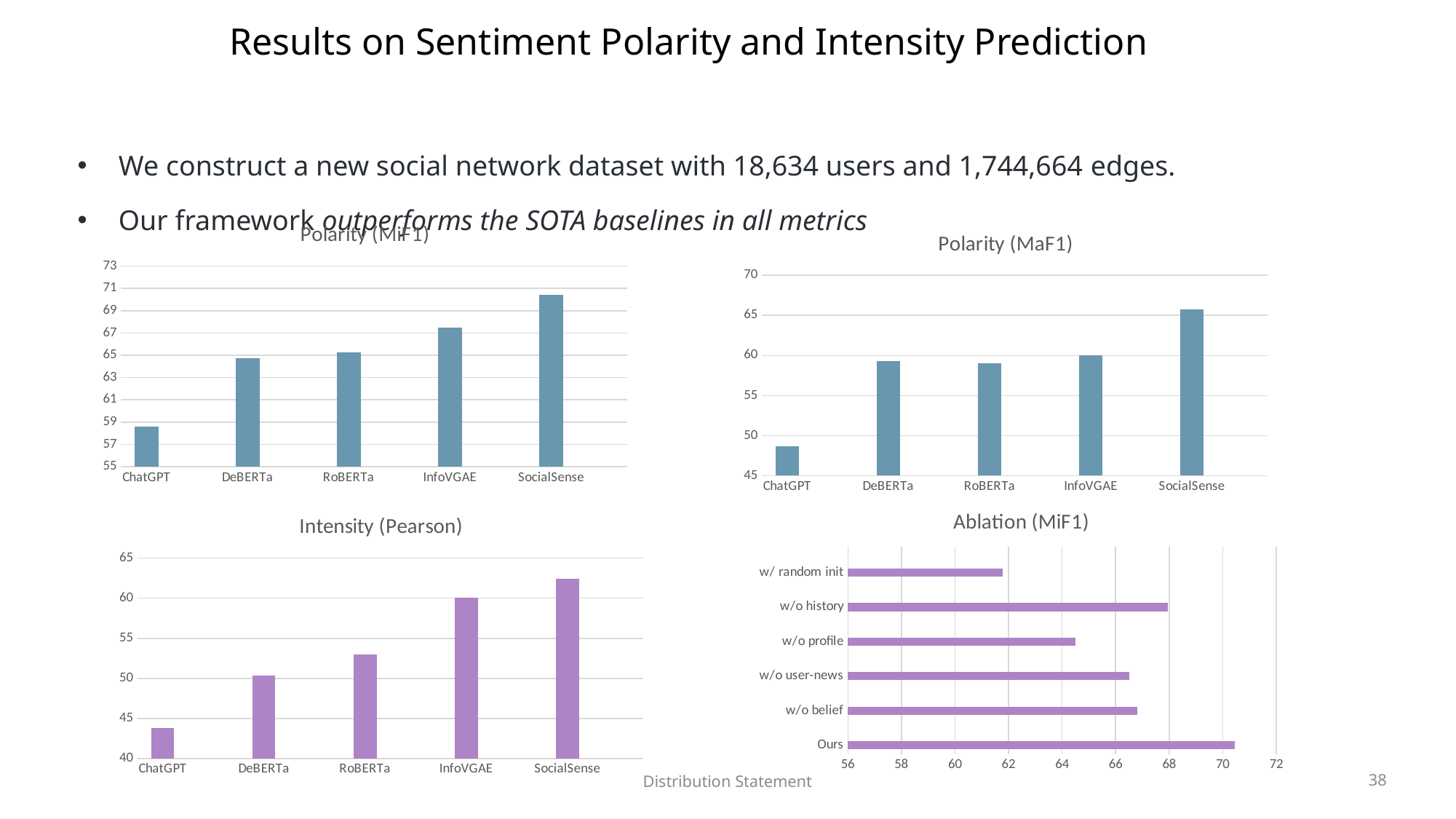
In the Polarity (MiF1) chart, is the value for ChatGPT greater or less than 59? less In the Ablation (MiF1) chart, which configuration has the lowest value? w/ random init In the Polarity (MaF1) chart, which is larger, the value for InfoVGAE or the value for SocialSense? SocialSense In the Intensity (Pearson) chart, do the values rise or fall from ChatGPT to SocialSense along the x axis? rise In the Polarity (MaF1) chart, is the value for SocialSense greater or less than 65? greater How many configurations are shown in the Ablation (MiF1) chart? 6 In the Polarity (MiF1) chart, which model has the lowest value? ChatGPT In the Polarity (MaF1) chart, which model has the lowest value? ChatGPT In the Intensity (Pearson) chart, is the value for ChatGPT greater or less than 45? less In the Intensity (Pearson) chart, which model has the highest value? SocialSense In the Ablation (MiF1) chart, which configuration has the highest value? Ours In the Polarity (MiF1) chart, which model has the highest value? SocialSense